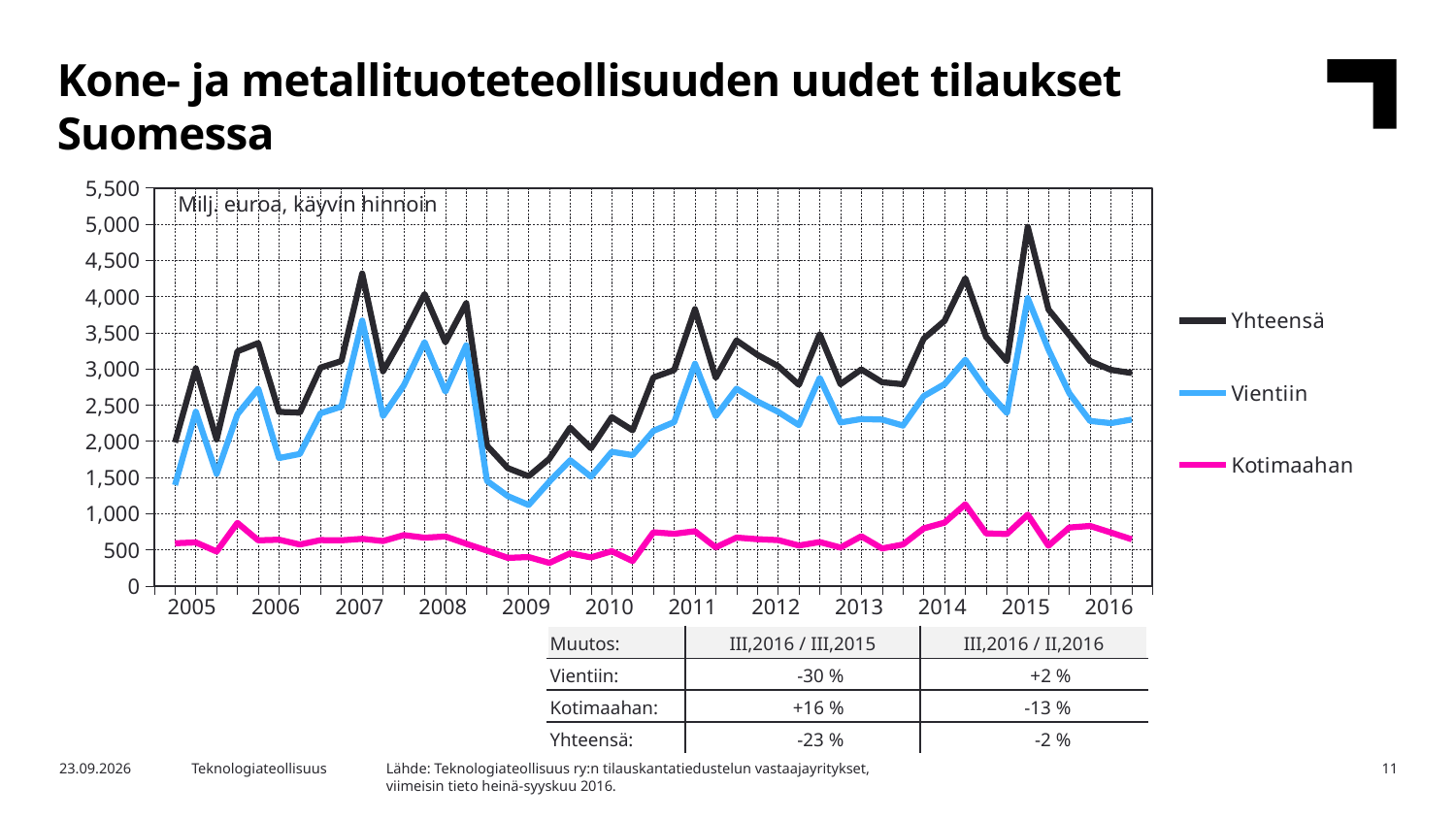
Is the lowest value of Vientiin in 2009 greater or less than 1,500? less How many years are labelled on the x axis of the chart? 12 Which series has the highest values throughout the chart? Yhteensä Is the peak value of Vientiin in 2015 greater or less than 3,500? greater Which series has the lowest values throughout the chart? Kotimaahan Which series are listed in the chart legend? Yhteensä, Vientiin, Kotimaahan Which series is larger in 2016, Vientiin or Kotimaahan? Vientiin How many series does the chart legend list? 3 Is the peak value of Yhteensä in 2015 greater or less than 4,500? greater Does the Yhteensä line rise or fall from its 2015 peak to the end of 2016? Fall What kind of chart is shown on the slide? Line chart What unit is stated in the label inside the chart area? Milj. euroa, käyvin hinnoin